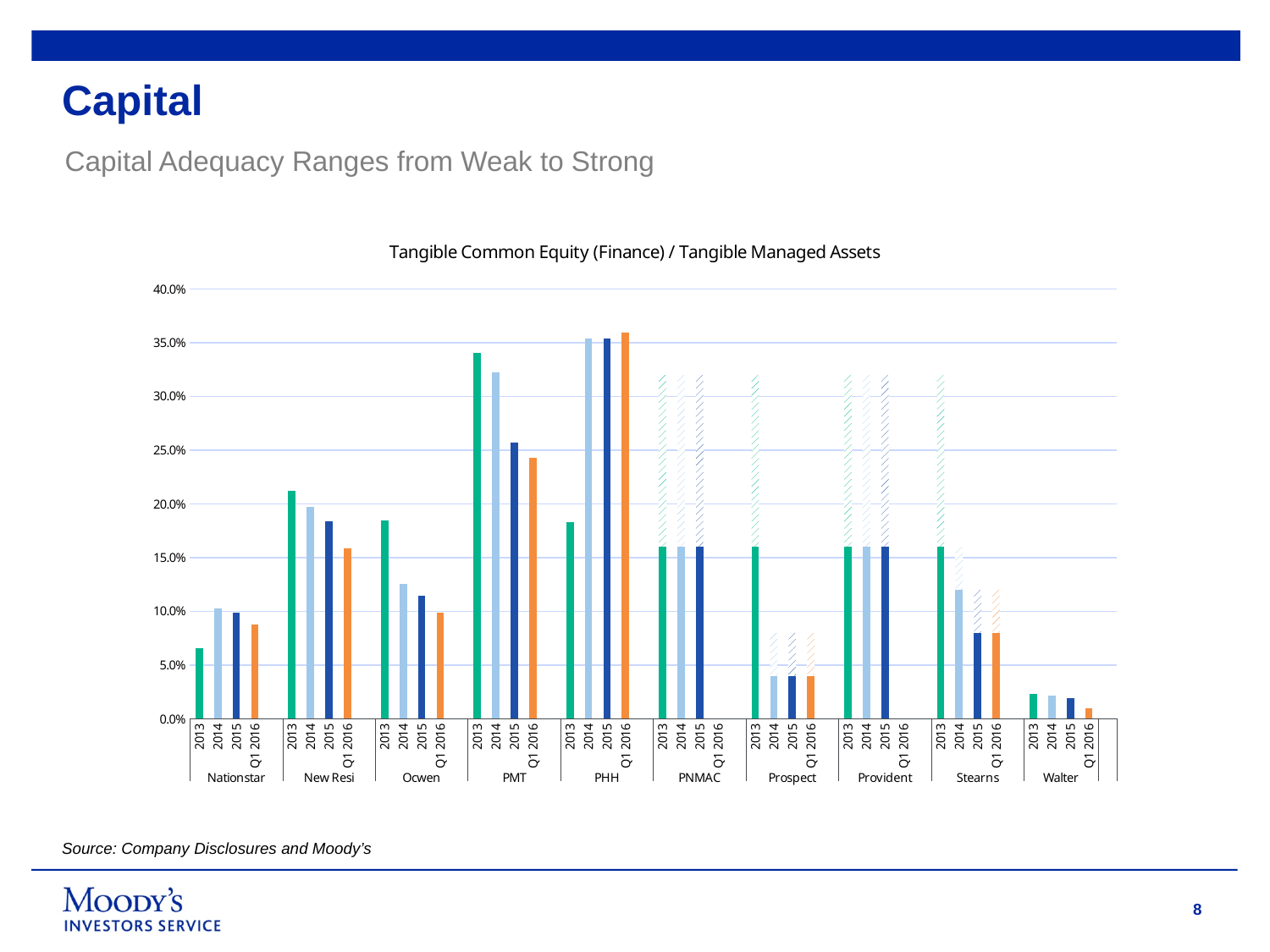
Do the values for New Resi rise or fall from 2013 to Q1 2016? fall Is the value for Walter in 2013 greater or less than 5.0%? less Which company has the lowest values across all periods in the chart? Walter What type of chart is shown on the slide? bar chart Which is larger, the 2013 value for PMT or the 2013 value for Ocwen? PMT Is the value for New Resi in 2013 greater or less than 20.0%? greater What is the title of the chart? Tangible Common Equity (Finance) / Tangible Managed Assets What is the source cited below the chart? Company Disclosures and Moody's Is the value for Prospect in 2014 greater or less than 5.0%? less How many companies are shown along the x axis of the chart? 10